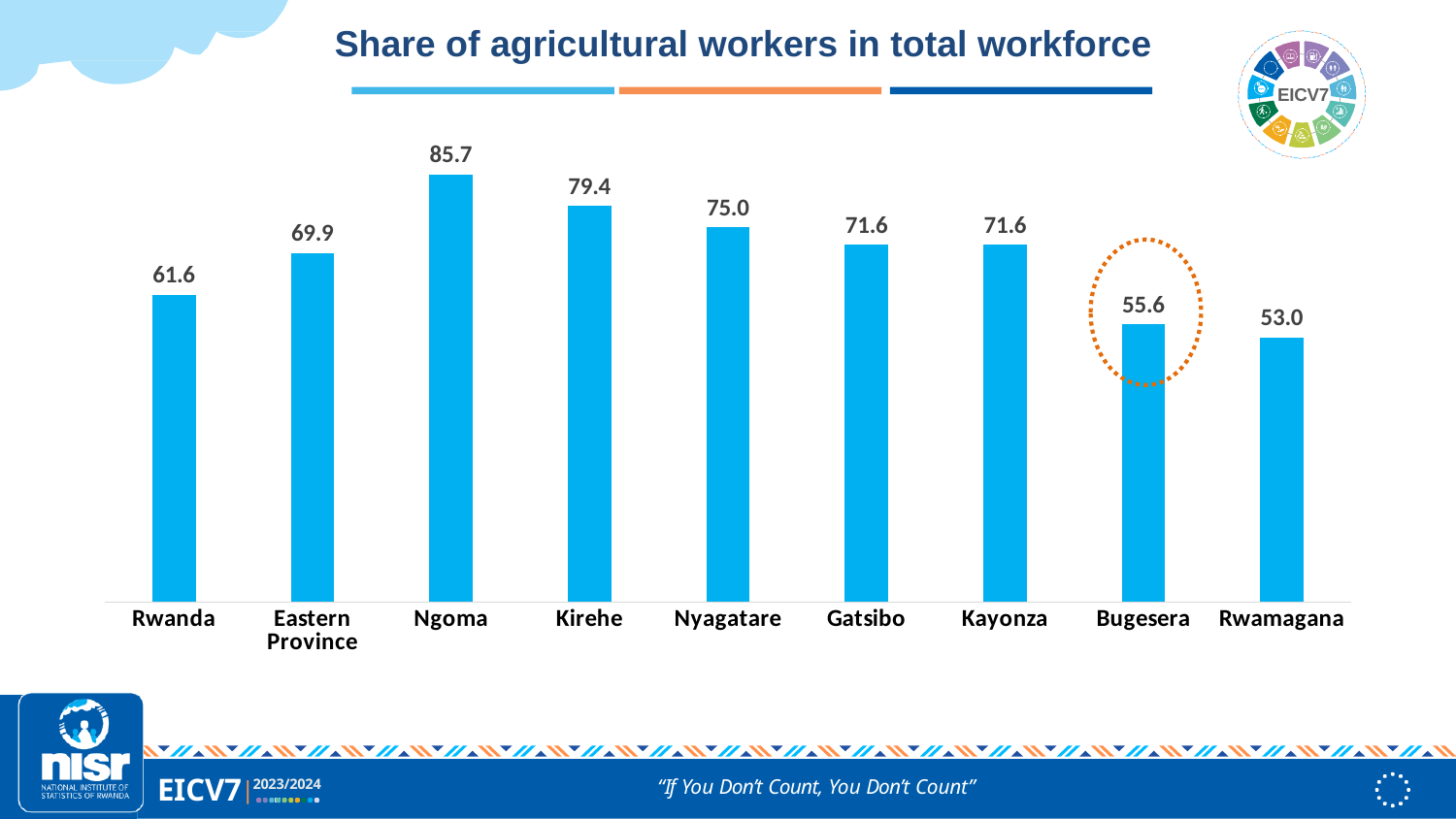
Which category has the highest share of agricultural workers? Ngoma Which is larger, the value for Rwanda or the value for Bugesera? Rwanda Which category has the lowest share of agricultural workers? Rwamagana What is the value shown for Bugesera? 55.6 What is the share of agricultural workers in the total workforce for Ngoma? 85.7 Which bar is highlighted with a dotted orange circle? Bugesera What is the value shown for Eastern Province? 69.9 What is the difference between the values for Ngoma and Rwamagana? 32.7 What kind of chart is shown on the slide? Bar chart How many categories are shown on the x axis? 9 What is the difference between the values for Kirehe and Rwanda? 17.8 Which is larger, the value for Nyagatare or the value for Gatsibo? Nyagatare